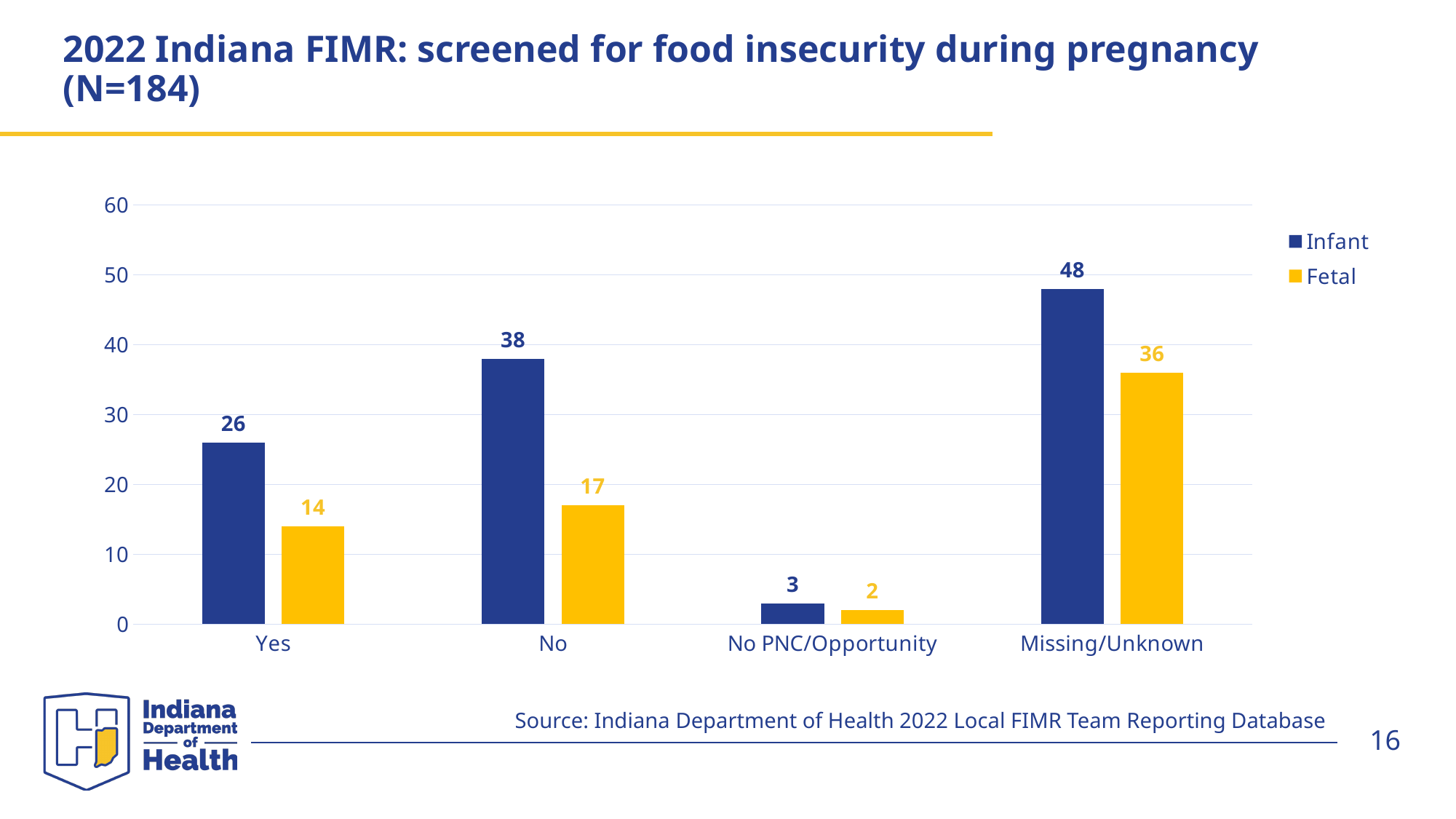
What is the Fetal value for "Missing/Unknown"? 36 Which is larger, the Infant value for "Yes" or the Fetal value for "Missing/Unknown"? Fetal value for Missing/Unknown Which category has the highest Infant value? Missing/Unknown Which category has the lowest Fetal value? No PNC/Opportunity What colour represents the Fetal series? Yellow How many series does the legend list? 2 What is the Infant value for the "Yes" category? 26 What is the difference between the Infant and Fetal values for "No"? 21 Is the Infant value for "Missing/Unknown" greater or less than 40? greater How many categories are shown on the x axis? 4 What kind of chart is shown on the slide? Bar chart What is the Fetal value for the "No" category? 17